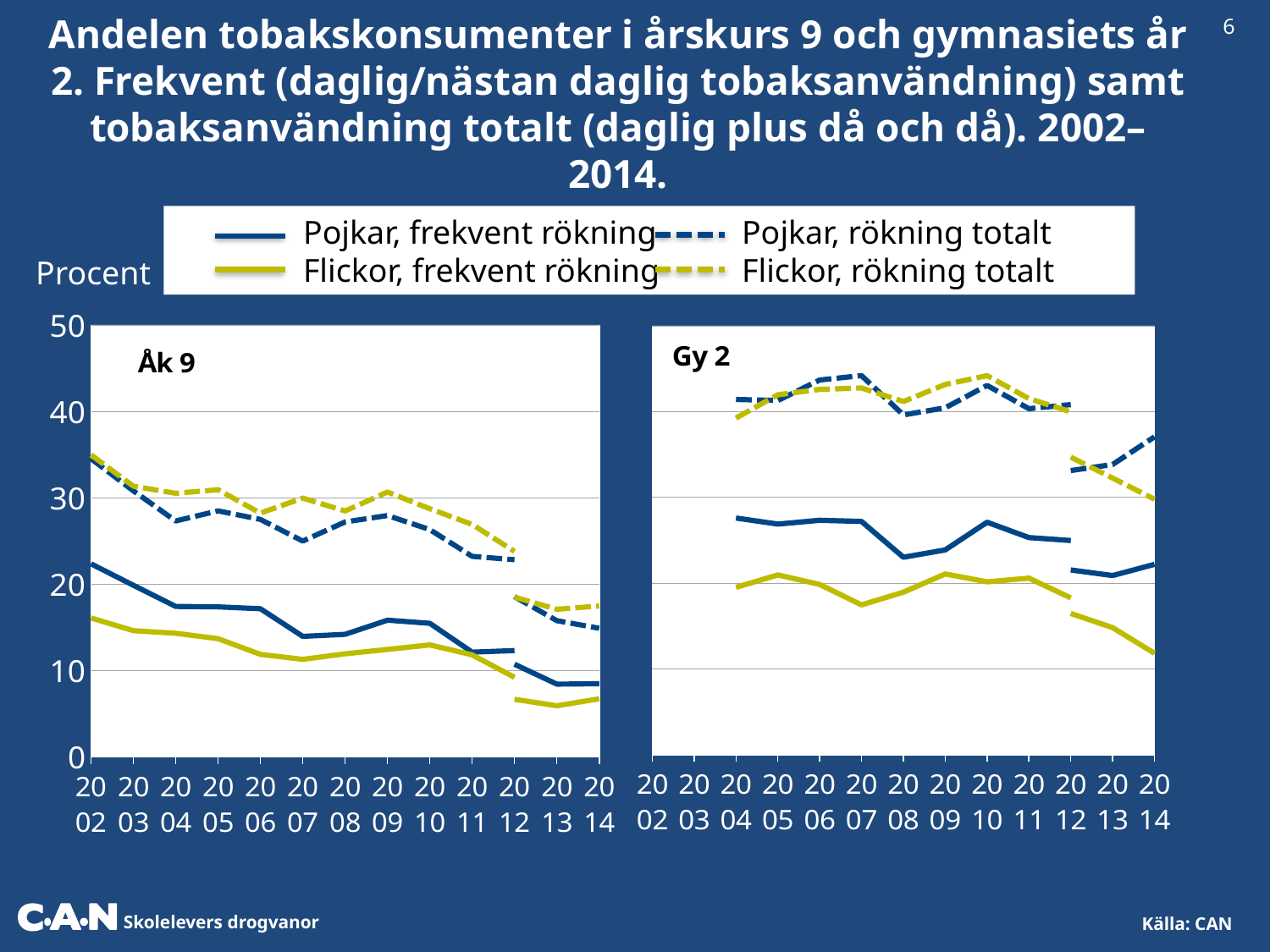
In the "Åk 9" chart, is the value for Pojkar, frekvent rökning in 2002 greater or less than 20? greater In the "Åk 9" chart, which is larger in 2002: Pojkar, frekvent rökning or Flickor, frekvent rökning? Pojkar, frekvent rökning What kind of chart is the "Åk 9" chart on the left? Line chart How many series does the legend list? 4 In the "Gy 2" chart, is the value for Pojkar, rökning totalt in 2010 greater or less than 40? greater In the "Åk 9" chart, is the value for Flickor, rökning totalt in 2002 greater or less than 30? greater How many years are shown on the x axis of the "Åk 9" chart? 13 In the "Gy 2" chart, which is larger in 2014: Pojkar, rökning totalt or Flickor, rökning totalt? Pojkar, rökning totalt In the "Åk 9" chart, does Pojkar, frekvent rökning rise or fall from 2002 to 2014? Fall What unit label is shown above the y axis of the charts? Procent